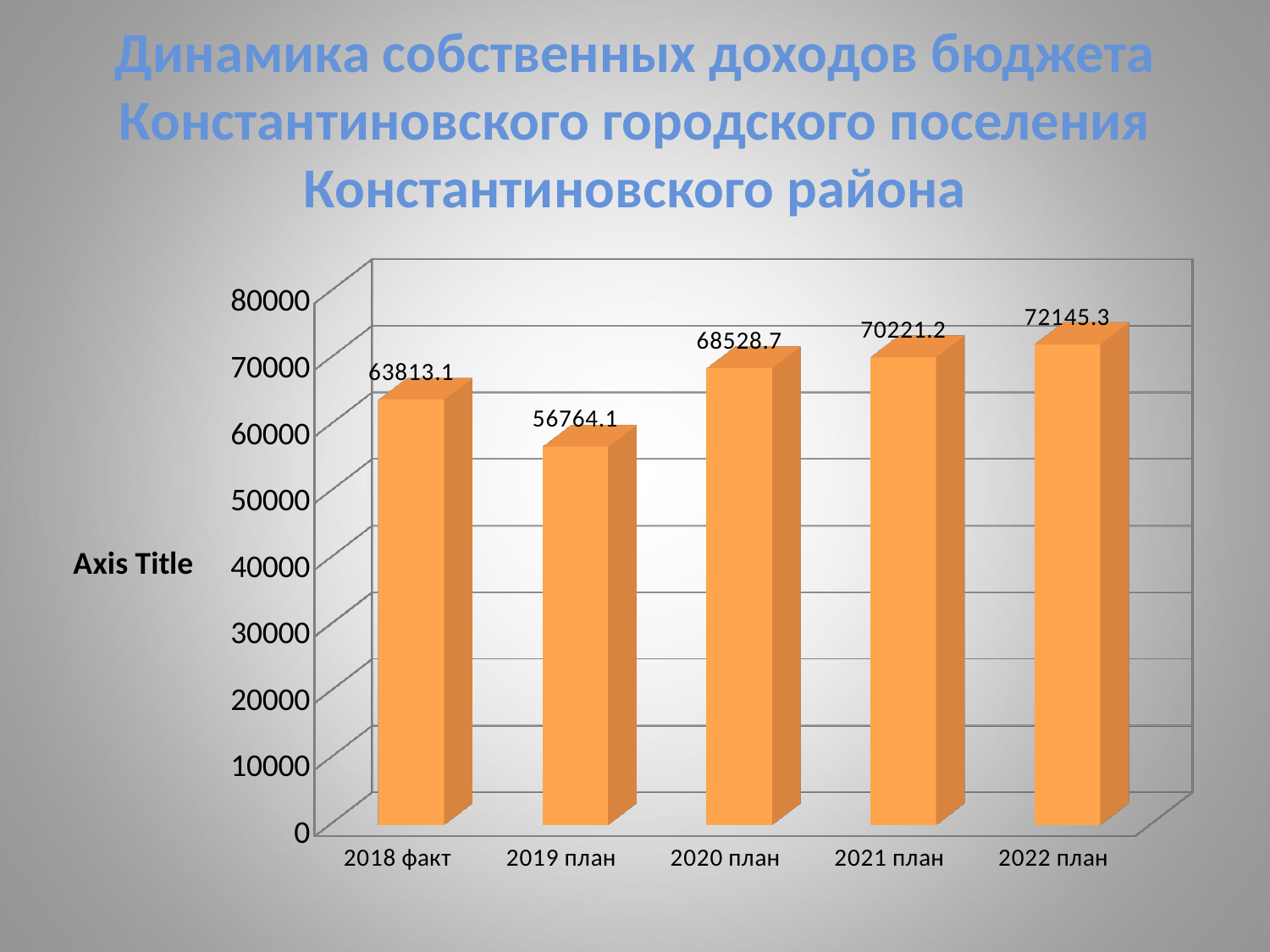
What is the value for 2019 план? 56764.1 Do the values rise or fall from 2019 план to 2022 план? rise Which category has the highest value? 2022 план What is the difference between the values for 2022 план and 2019 план? 15381.2 Which category has the lowest value? 2019 план How many categories are shown on the x axis? 5 What is the difference between the values for 2020 план and 2018 факт? 4715.6 Which is larger, the value for 2018 факт or the value for 2020 план? 2020 план What is the value for 2018 факт? 63813.1 Is the value for 2021 план greater or less than 60000? greater What kind of chart is shown on the slide? bar chart What is the value for 2022 план? 72145.3